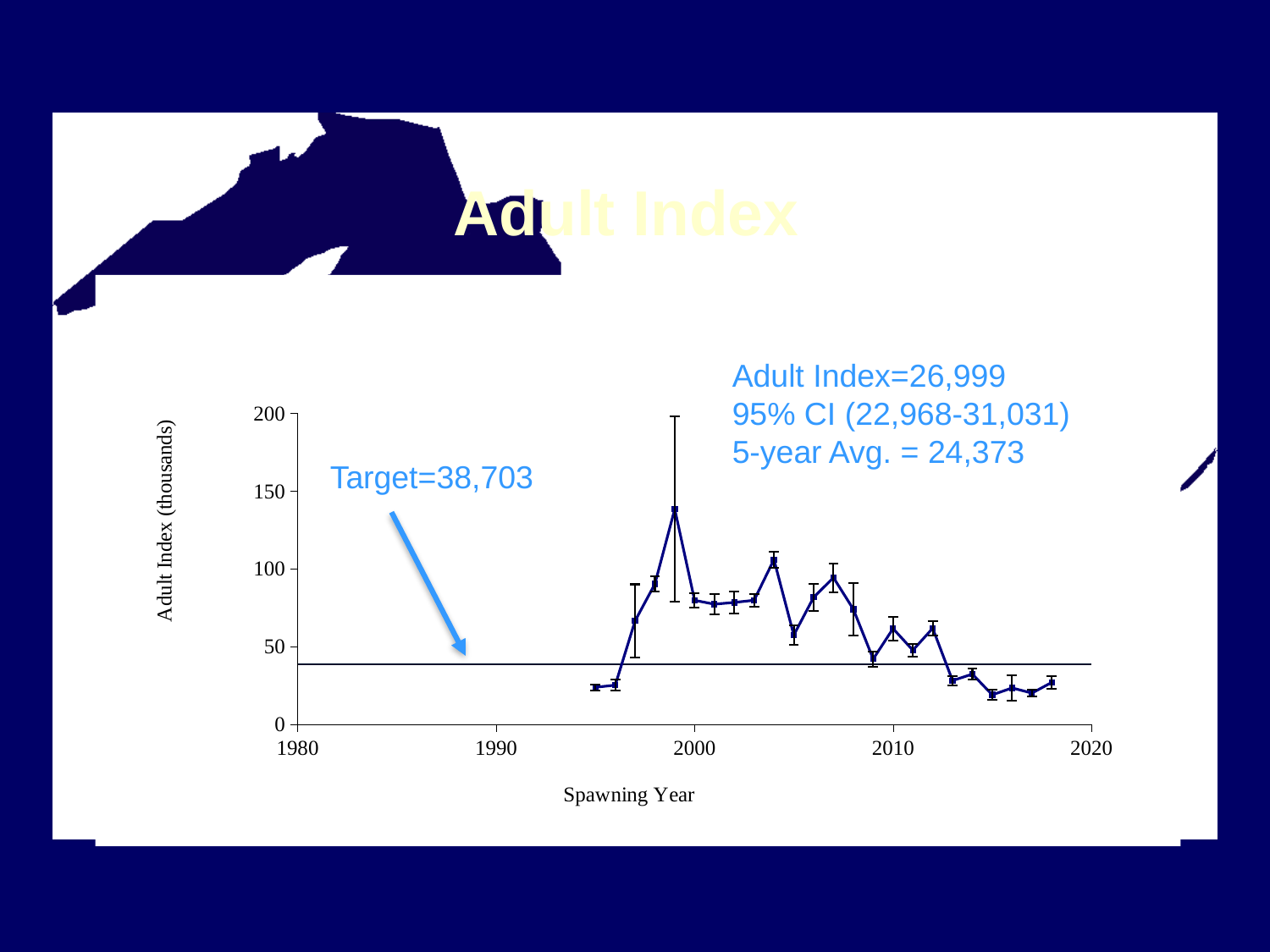
What Adult Index value is annotated on the chart? 26,999 What target value is annotated on the chart? 38,703 Do the Adult Index values generally rise or fall from 2007 to 2018? fall What is the label of the x axis? Spawning Year Which spawning year has the larger Adult Index, 2010 or 2015? 2010 Is the Adult Index value for 1999 greater or less than 100? greater What 95% confidence interval is annotated on the chart? 22,968-31,031 In which spawning year does the Adult Index reach its highest point? 1999 What kind of chart is shown on the slide? line chart What is the title of the chart? Adult Index What 5-year average is annotated on the chart? 24,373 Is the Adult Index value for 2018 greater or less than 50? less